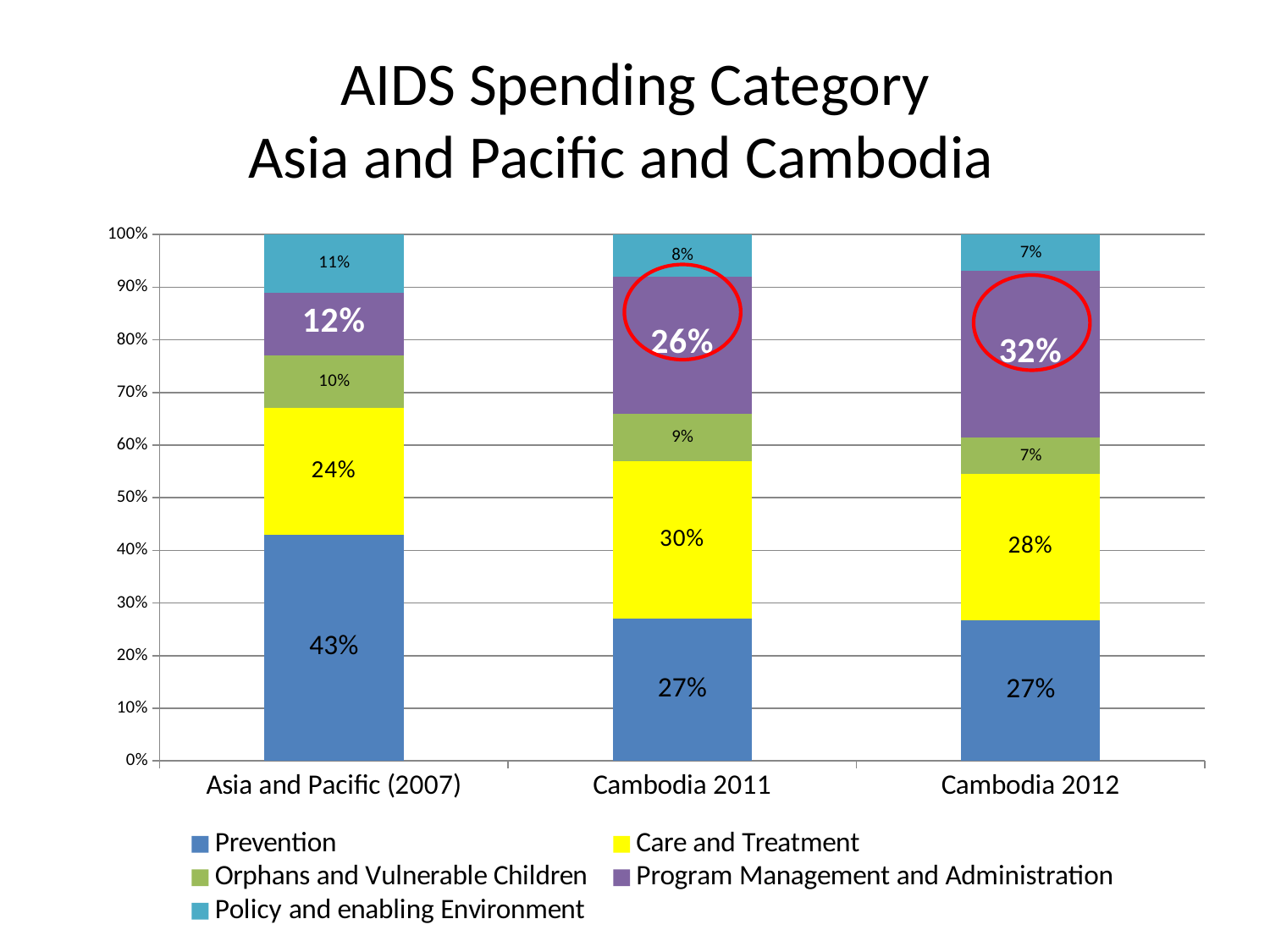
What is the difference between the Program Management and Administration share in Cambodia 2012 and in Cambodia 2011? 6% Which category has the lowest Orphans and Vulnerable Children share? Cambodia 2012 What is the Policy and enabling Environment share for Asia and Pacific (2007)? 11% How many categories are shown on the x axis? 3 Does the Program Management and Administration share rise or fall from Asia and Pacific (2007) to Cambodia 2012? Rise Which category has the highest Program Management and Administration share? Cambodia 2012 Which is larger: the Prevention share in Asia and Pacific (2007) or in Cambodia 2011? Asia and Pacific (2007) What is the Care and Treatment share for Cambodia 2011? 30% What is the Program Management and Administration share for Cambodia 2012? 32% What kind of chart is shown on the slide? Stacked bar chart How many series does the legend list? 5 What percentage of AIDS spending went to Prevention in Asia and Pacific (2007)? 43%